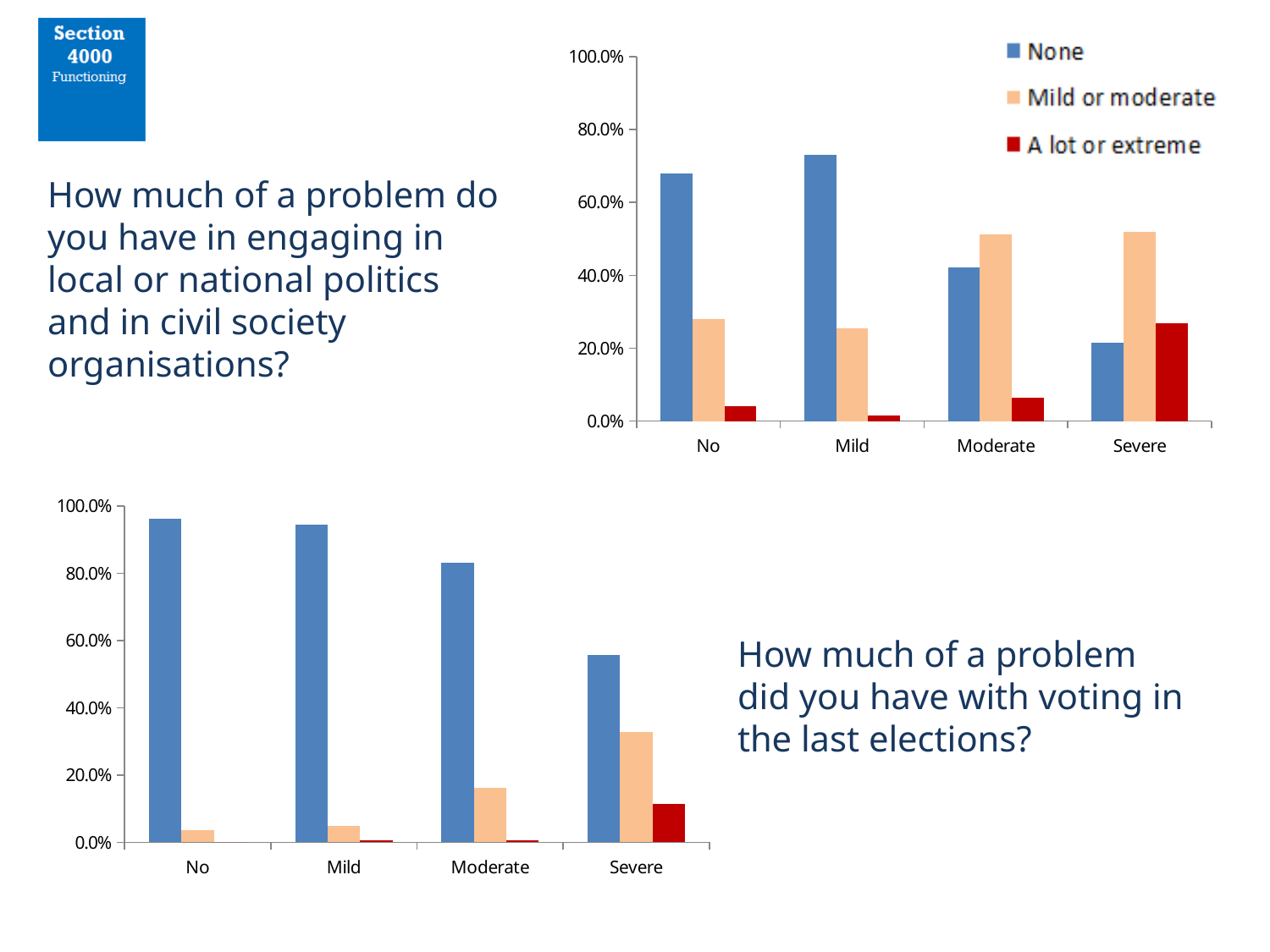
In the bottom-left chart about voting, is the blue bar for Severe greater or less than 40.0%? greater In the top-right chart, which is larger for the Moderate category: 'None' or 'Mild or moderate'? Mild or moderate What colour represents 'A lot or extreme' in the legend of the top-right chart? red In the bottom-left chart about voting, which category has the highest orange bar? Severe How many series does the legend of the top-right chart list? 3 In the bottom-left chart about voting, do the blue bars rise or fall from No to Severe? fall In the top-right chart, which category has the lowest 'None' value? Severe In the top-right chart, is the 'None' value for Mild greater or less than 60.0%? greater How many categories are shown on the x axis of the top-right chart? 4 In the top-right chart, which category has the highest 'None' value? Mild In the top-right chart, is the 'A lot or extreme' value for Severe greater or less than 20.0%? greater What kind of chart is the top-right chart about engaging in local or national politics? bar chart